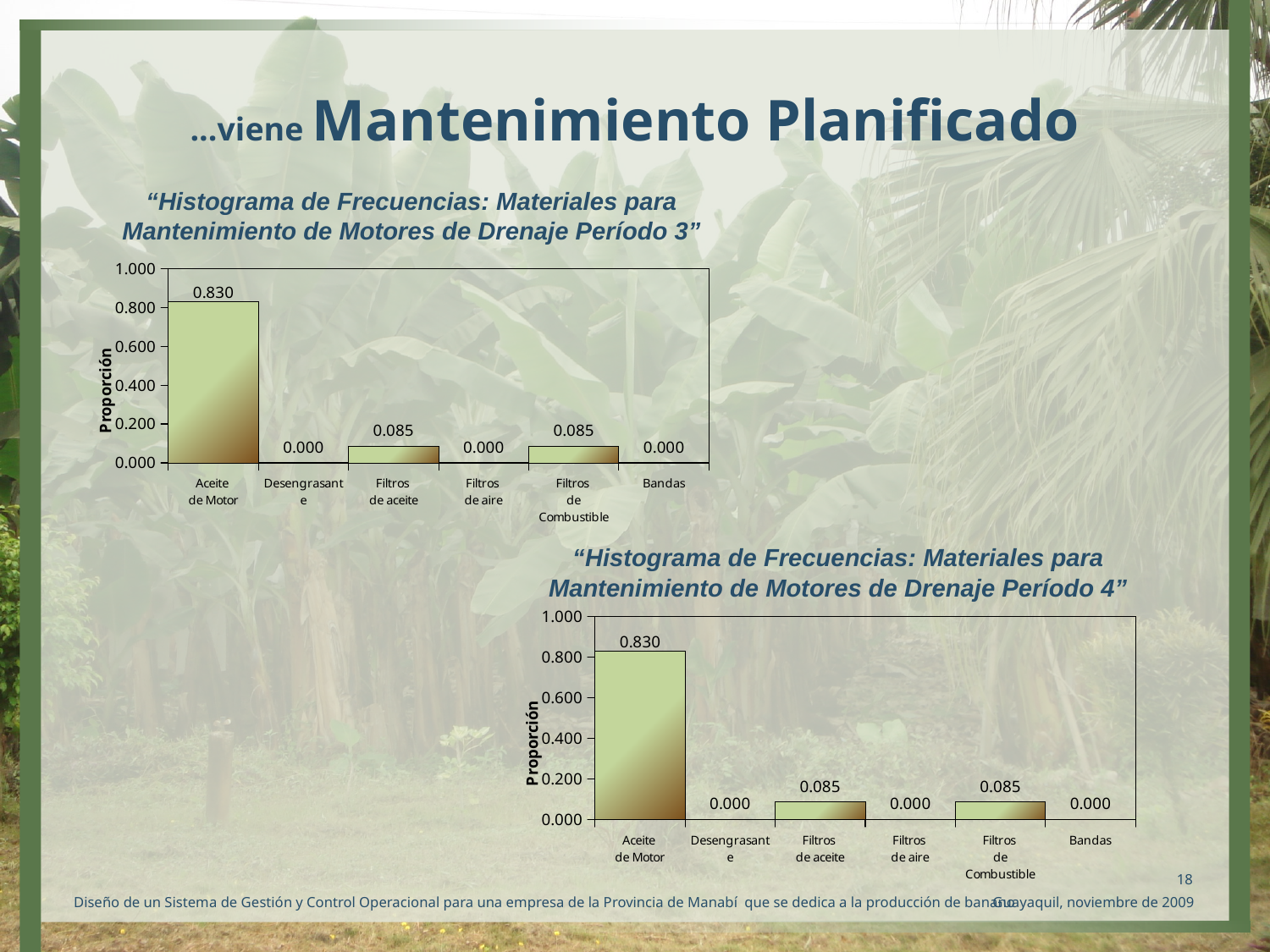
What is the label on the vertical axis of the Período 4 chart? Proporción In the Período 4 chart, what is the difference between the values for Aceite de Motor and Filtros de aceite? 0.745 In the Período 4 chart, what is the value for Filtros de Combustible? 0.085 In the Período 4 chart, what is the value for Filtros de aceite? 0.085 In the Período 3 chart, what is the value for Aceite de Motor? 0.830 What kind of chart is the Período 4 chart? Bar chart In the Período 3 chart, which is larger, the value for Filtros de aceite or the value for Filtros de aire? Filtros de aceite In the Período 3 chart, what is the value for Desengrasante? 0.000 How many categories are shown in the Período 3 chart? 6 In the Período 3 chart, what is the value for Bandas? 0.000 In the Período 4 chart, is the value for Aceite de Motor greater or less than 0.600? greater In the Período 3 chart, which category has the highest value? Aceite de Motor